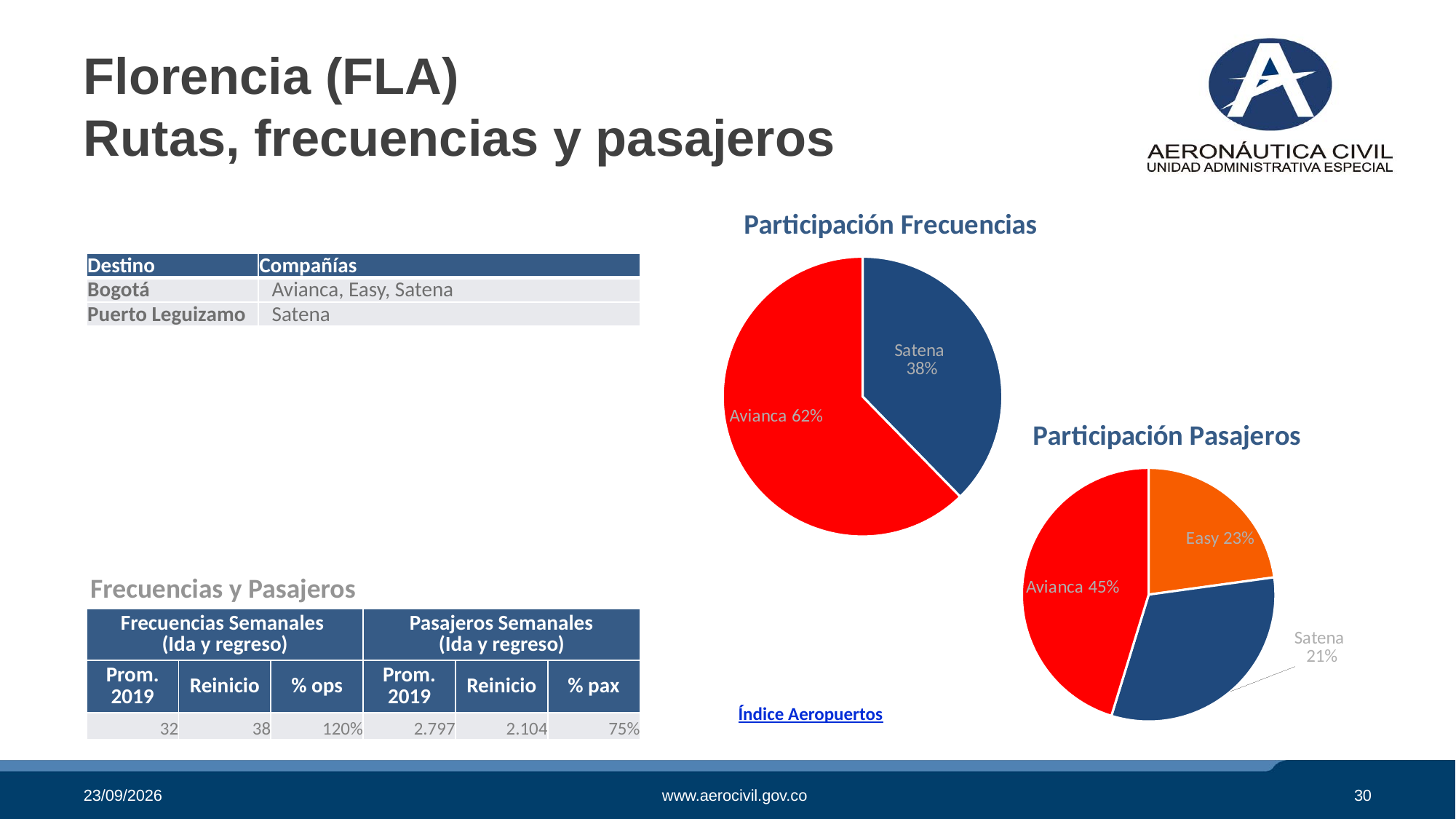
In the 'Participación Frecuencias' chart, which company has the largest share? Avianca In the 'Participación Pasajeros' chart, what share does Easy have? 23% In the 'Participación Frecuencias' chart, what share does Avianca have? 62% In the 'Participación Frecuencias' chart, what share does Satena have? 38% In the 'Participación Pasajeros' chart, what colour is the Easy slice? Orange What kind of chart is 'Participación Frecuencias'? Pie chart In the 'Participación Frecuencias' chart, what is the difference between Avianca's and Satena's shares? 24% In the 'Participación Pasajeros' chart, what share does Avianca have? 45% In the 'Participación Pasajeros' chart, what share does Satena have? 21% How many slices does the 'Participación Pasajeros' chart have? 3 How many slices does the 'Participación Frecuencias' chart have? 2